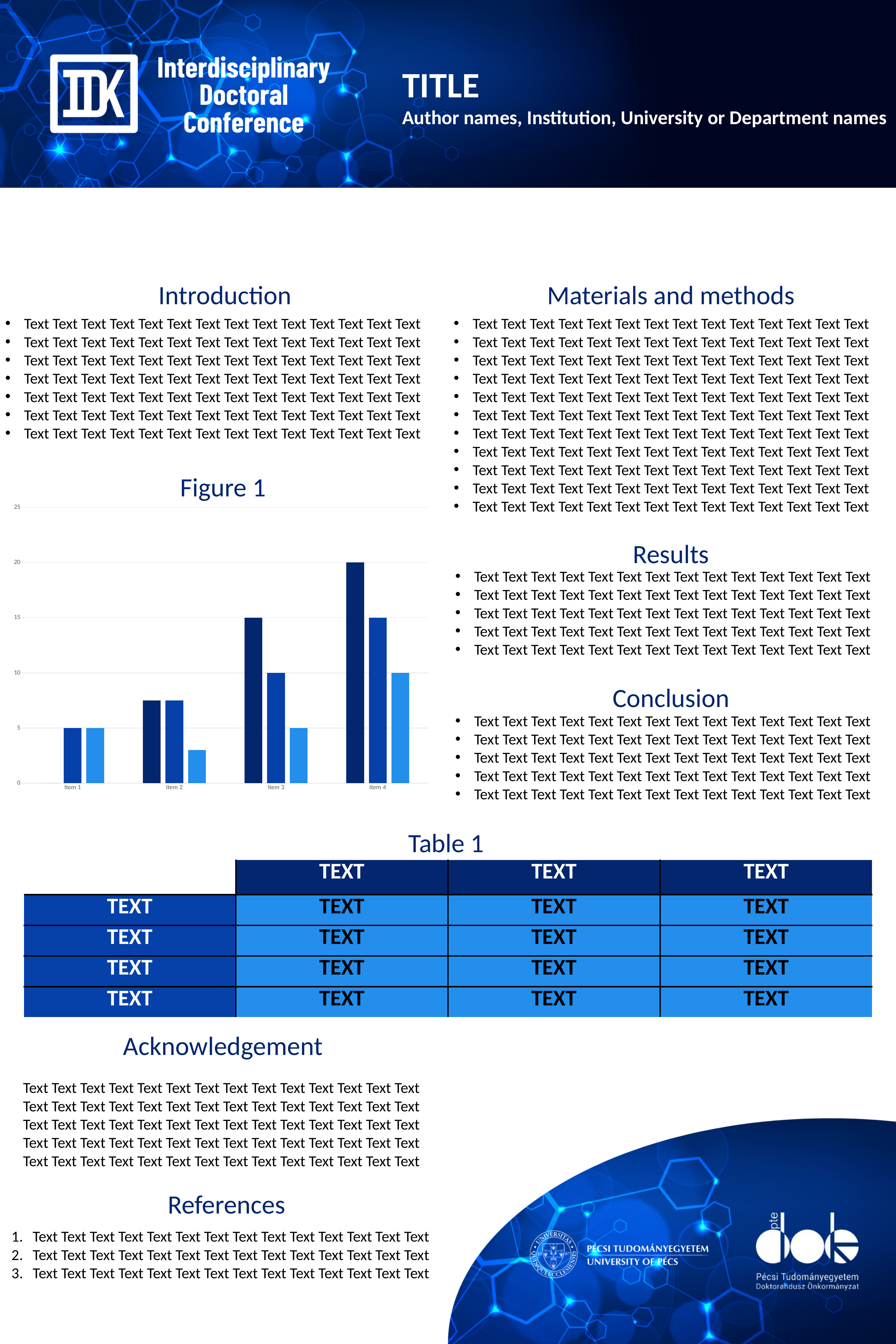
In Figure 1, which category has the tallest bar overall? Item 4 In Figure 1, which is larger: the dark navy bar for Item 3 or the dark navy bar for Item 2? Item 3 What kind of chart is Figure 1? bar chart In Figure 1, which category contains the shortest bar? Item 2 In Figure 1, is the dark navy bar for Item 2 greater or less than 10? less In Figure 1, do the dark navy bars rise or fall from Item 1 to Item 4? rise In Figure 1, is the light blue bar for Item 2 greater or less than 5? less In Figure 1, what is the value of the dark navy bar for Item 4? 20 In Figure 1, what is the value of the light blue bar for Item 1? 5 In Figure 1, what is the difference between the dark navy bar for Item 4 and the dark navy bar for Item 3? 5 In Figure 1, what is the value of the dark navy bar for Item 3? 15 How many categories are shown on the x axis of Figure 1? 4